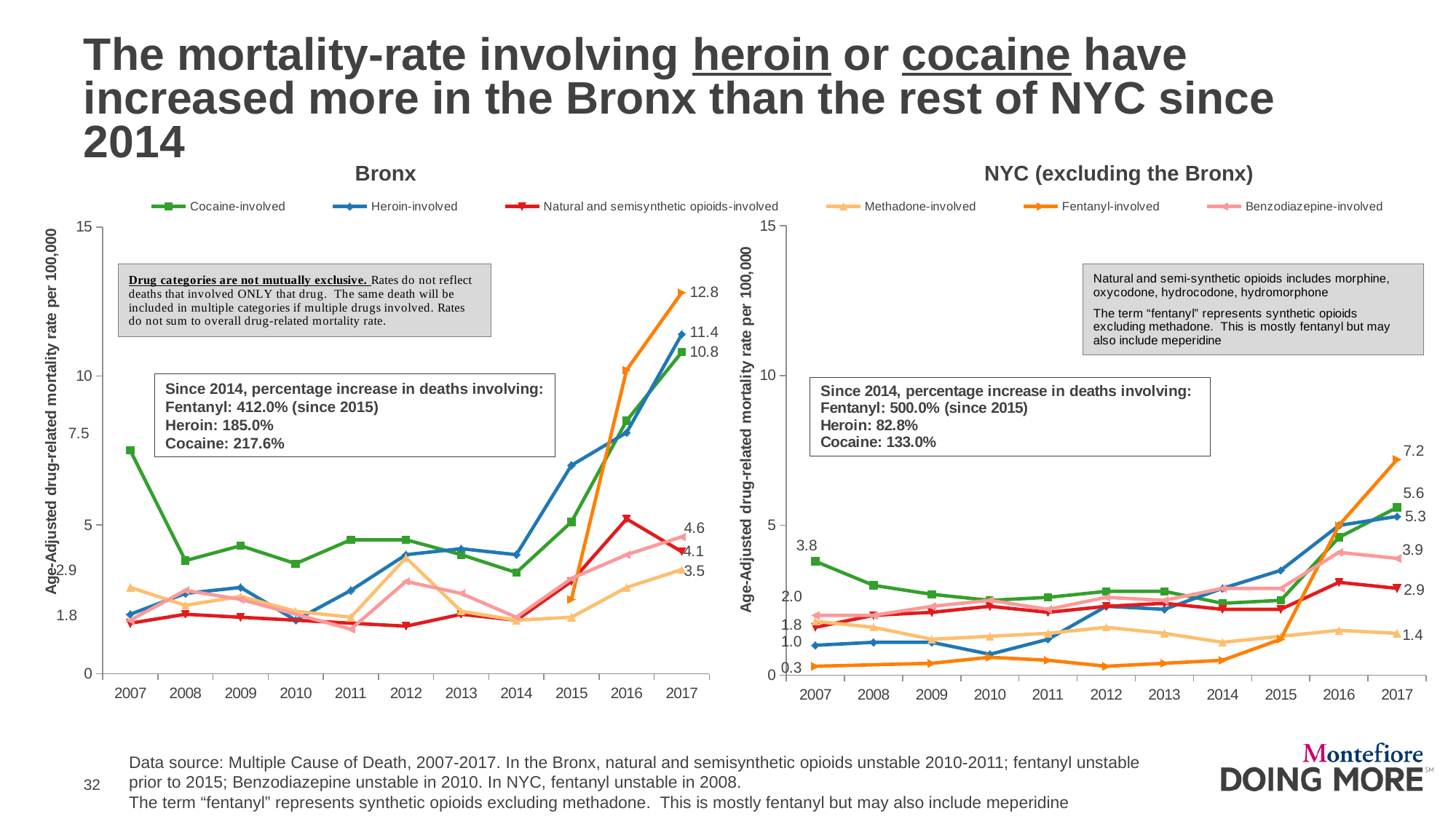
On the Bronx chart, is the value for Cocaine-involved in 2007 greater or less than 5? greater On the Bronx chart, what is the value for Fentanyl-involved in 2017? 12.8 On the Bronx chart, what is the difference between the 2017 values for Heroin-involved and Cocaine-involved? 0.6 On the Bronx chart, what is the value for Heroin-involved in 2017? 11.4 On the NYC (excluding the Bronx) chart, what is the value for Cocaine-involved in 2007? 3.8 On the NYC (excluding the Bronx) chart, what is the value for Fentanyl-involved in 2017? 7.2 How many years are shown on the x axis of the Bronx chart? 11 What kind of chart is the NYC (excluding the Bronx) chart? line chart How many series does the legend list? 6 On the NYC (excluding the Bronx) chart, which series has the lowest value in 2017? Methadone-involved On the Bronx chart, which series has the highest value in 2017? Fentanyl-involved Which is larger: the 2017 Fentanyl-involved value on the Bronx chart or on the NYC (excluding the Bronx) chart? Bronx